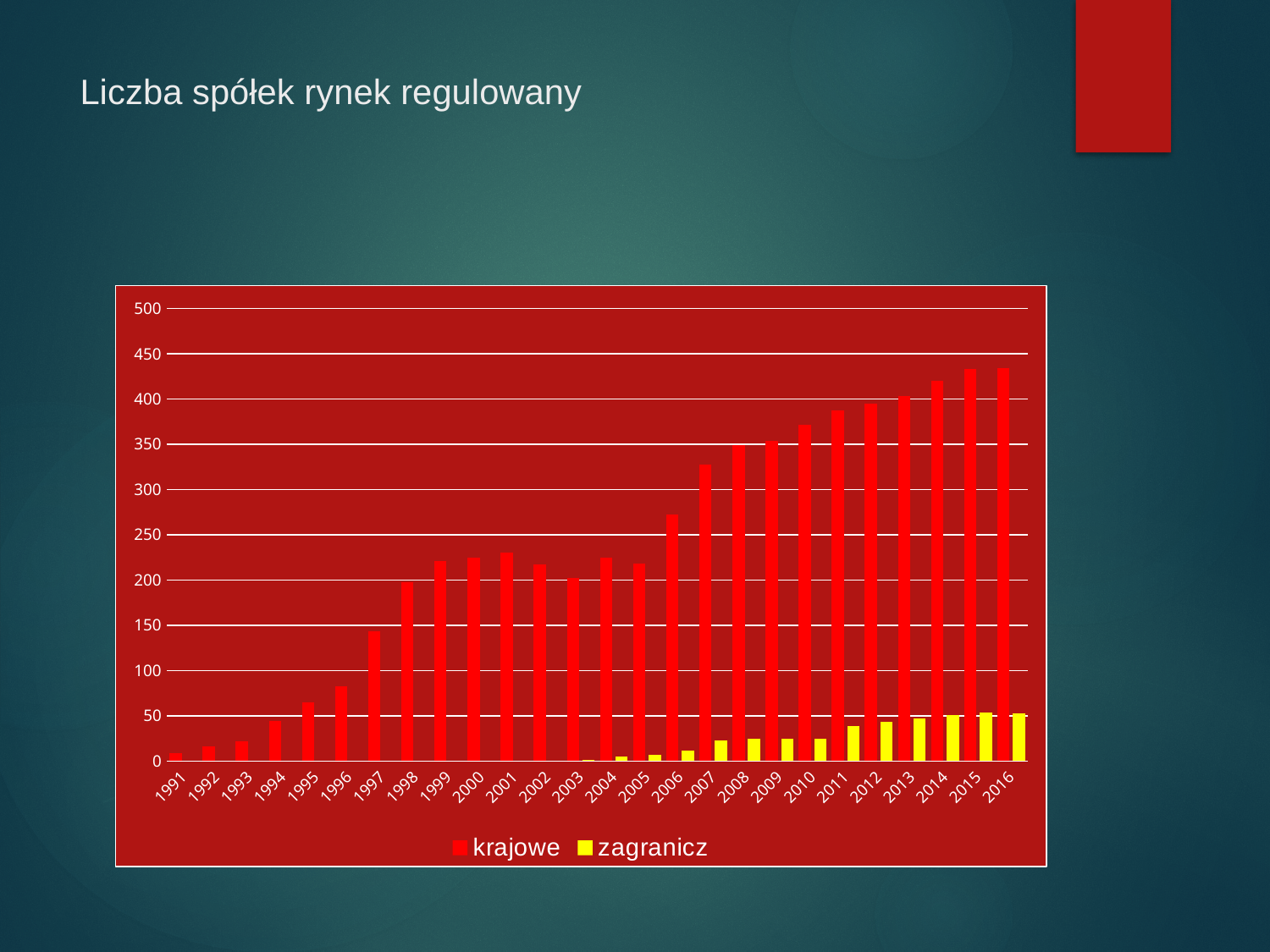
Which colour represents the zagranicz series? yellow How many years are shown on the x axis of the chart? 26 Is the value for krajowe in 1991 greater or less than 50? less Is the value for krajowe in 2007 greater or less than 300? greater Which year has the lowest value for krajowe? 1991 Overall, do the krajowe values rise or fall from 1991 to 2016? rise Is the value for zagranicz in 2011 greater or less than 50? less Which is larger, the krajowe value for 2006 or for 2007? 2007 What kind of chart is shown on the slide? bar chart What are the two series named in the legend? krajowe and zagranicz How many series does the chart legend list? 2